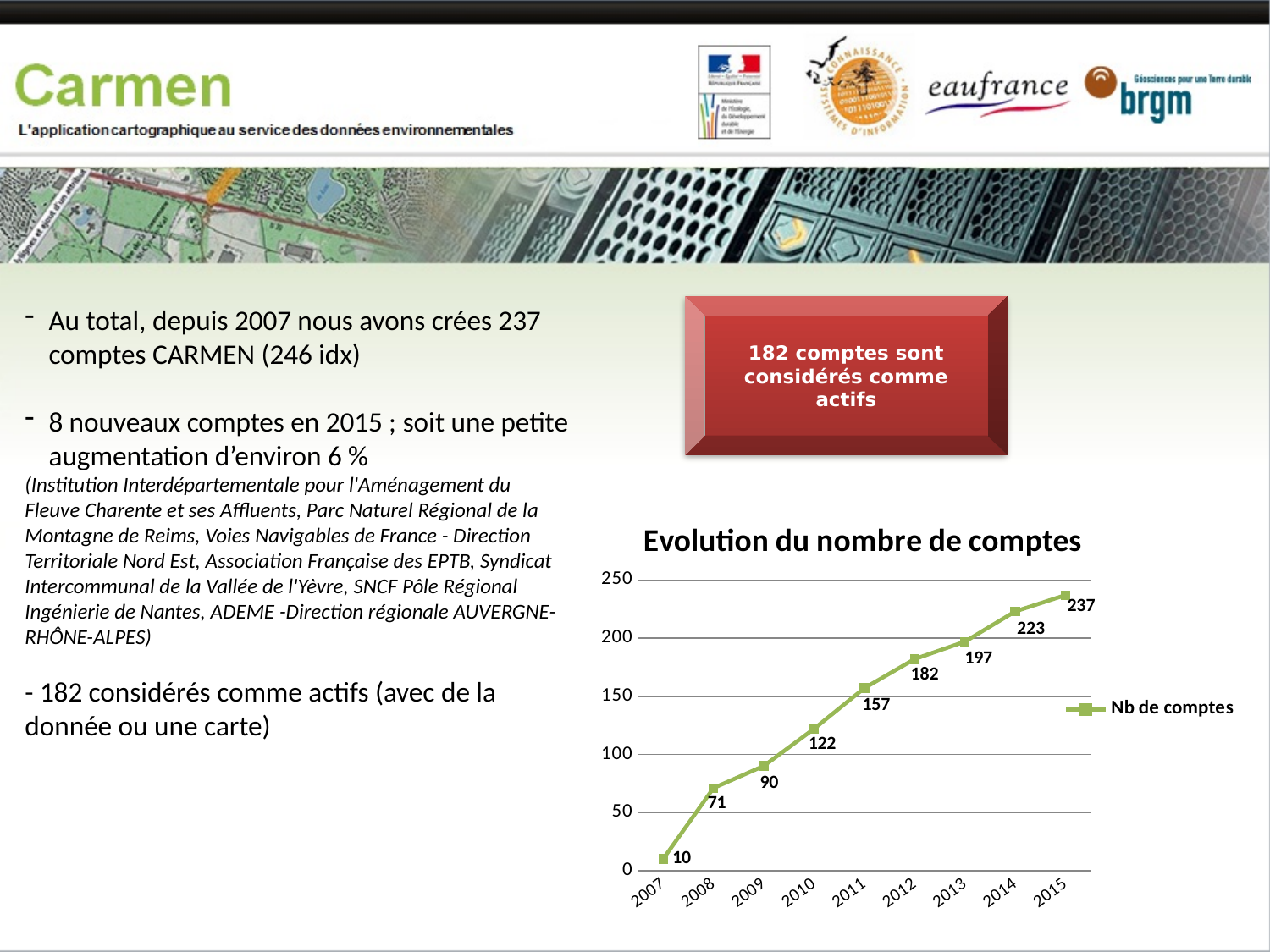
What is the value for 2011 in the 'Evolution du nombre de comptes' chart? 157 What is the difference between the values for 2015 and 2014 in the 'Evolution du nombre de comptes' chart? 14 Which year has the lowest value in the 'Evolution du nombre de comptes' chart? 2007 Do the values in the 'Evolution du nombre de comptes' chart rise or fall from 2007 to 2015? rise What is the difference between the values for 2008 and 2007 in the 'Evolution du nombre de comptes' chart? 61 What is the value for 2014 in the 'Evolution du nombre de comptes' chart? 223 What is the value for 2007 in the 'Evolution du nombre de comptes' chart? 10 Is the value for 2012 in the 'Evolution du nombre de comptes' chart greater or less than 150? greater How many years are plotted on the x axis of the 'Evolution du nombre de comptes' chart? 9 What kind of chart is 'Evolution du nombre de comptes'? line chart Which is larger in the 'Evolution du nombre de comptes' chart, the value for 2010 or the value for 2009? 2010 Which year has the highest value in the 'Evolution du nombre de comptes' chart? 2015